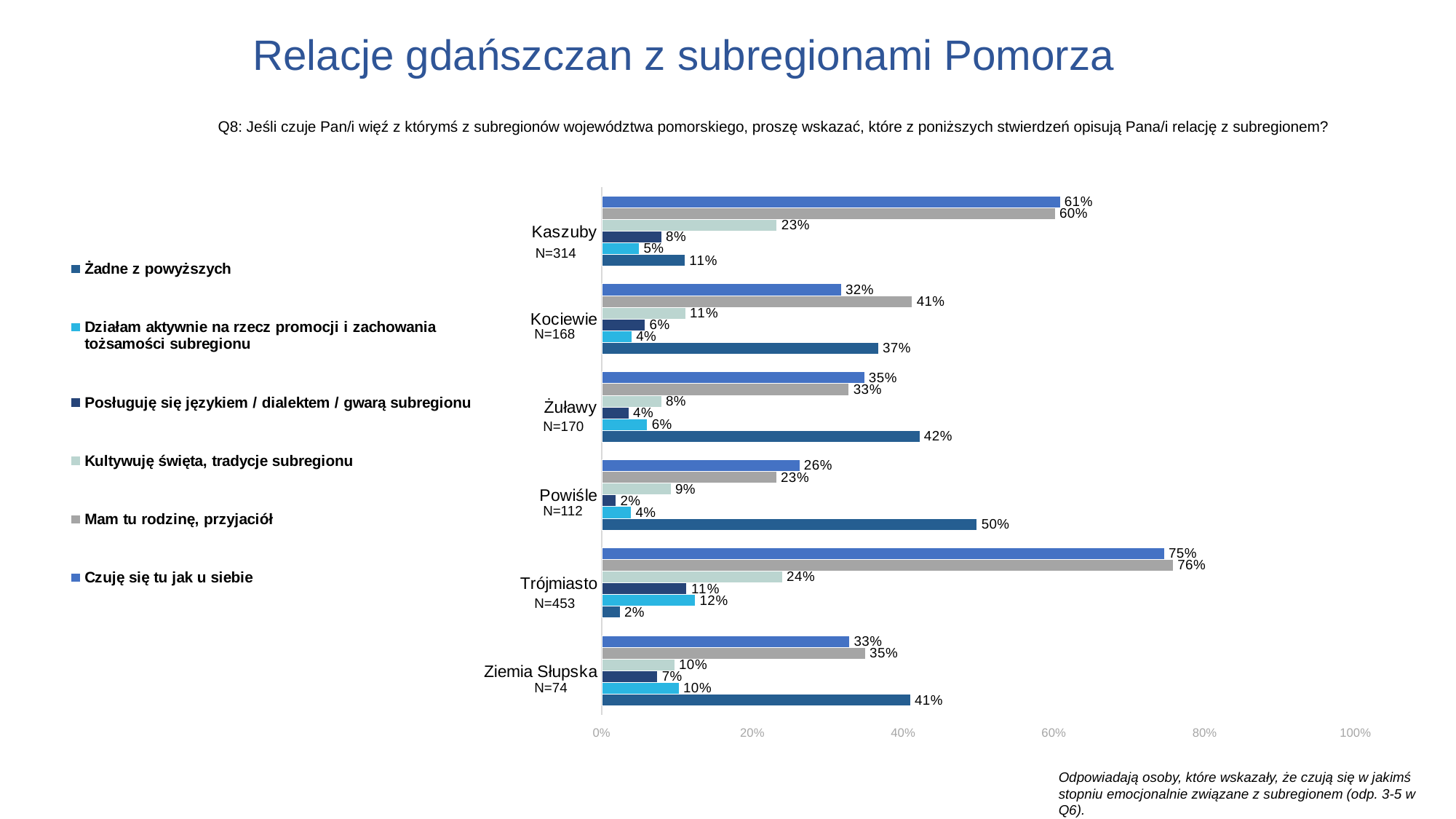
What is the sample size (N) shown for Ziemia Słupska? N=74 What percentage of Kaszuby respondents chose "Kultywuję święta, tradycje subregionu"? 23% What percentage of Trójmiasto respondents chose "Mam tu rodzinę, przyjaciół"? 76% How many subregions are shown on the chart? 6 What is the value for "Żadne z powyższych" in Powiśle? 50% What type of chart is shown on the slide? Bar chart Which subregion has the highest value for "Czuję się tu jak u siebie"? Trójmiasto How many series does the legend list? 6 Is the value for "Mam tu rodzinę, przyjaciół" in Kaszuby greater or less than 40%? greater Which subregion has the lowest value for "Żadne z powyższych"? Trójmiasto What is the difference between "Czuję się tu jak u siebie" for Kaszuby and for Kociewie? 29 percentage points Which is larger for Żuławy: "Czuję się tu jak u siebie" or "Żadne z powyższych"? Żadne z powyższych